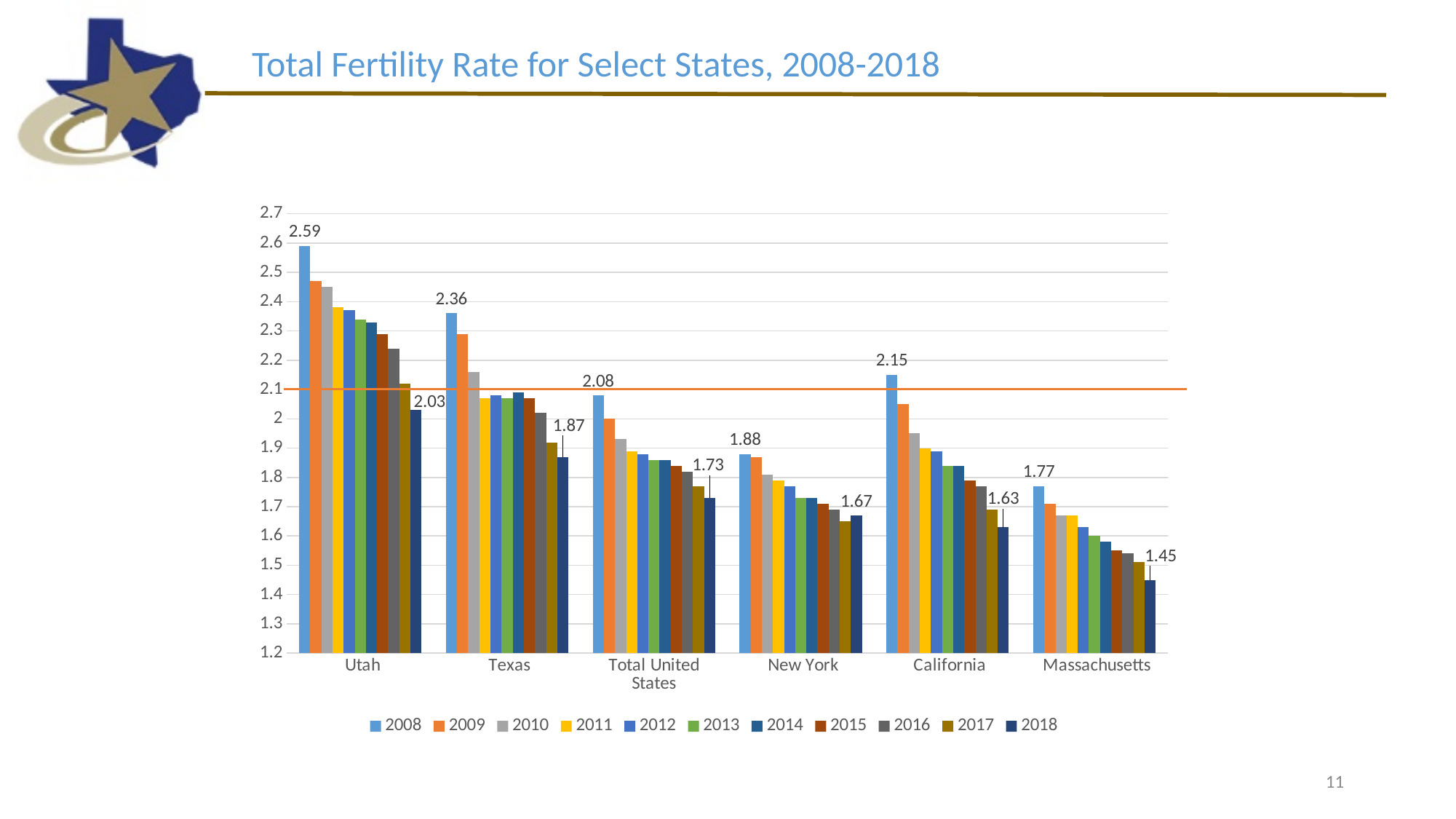
Is the 2012 value for Utah greater or less than 2.3? greater Which category has the lowest total fertility rate in 2018? Massachusetts What is the 2008 value for California? 2.15 What kind of chart is shown on the slide? Bar chart Which state has the highest total fertility rate in 2008? Utah What is the total fertility rate for Utah in 2008? 2.59 What is the difference between the 2008 values for Utah and Massachusetts? 0.82 How many series does the legend list? 11 What is the total fertility rate for Texas in 2018? 1.87 By how much did Texas's total fertility rate fall from 2008 to 2018? 0.49 Which is larger, the 2018 value for New York or the 2018 value for California? New York What is the 2018 value for Massachusetts? 1.45